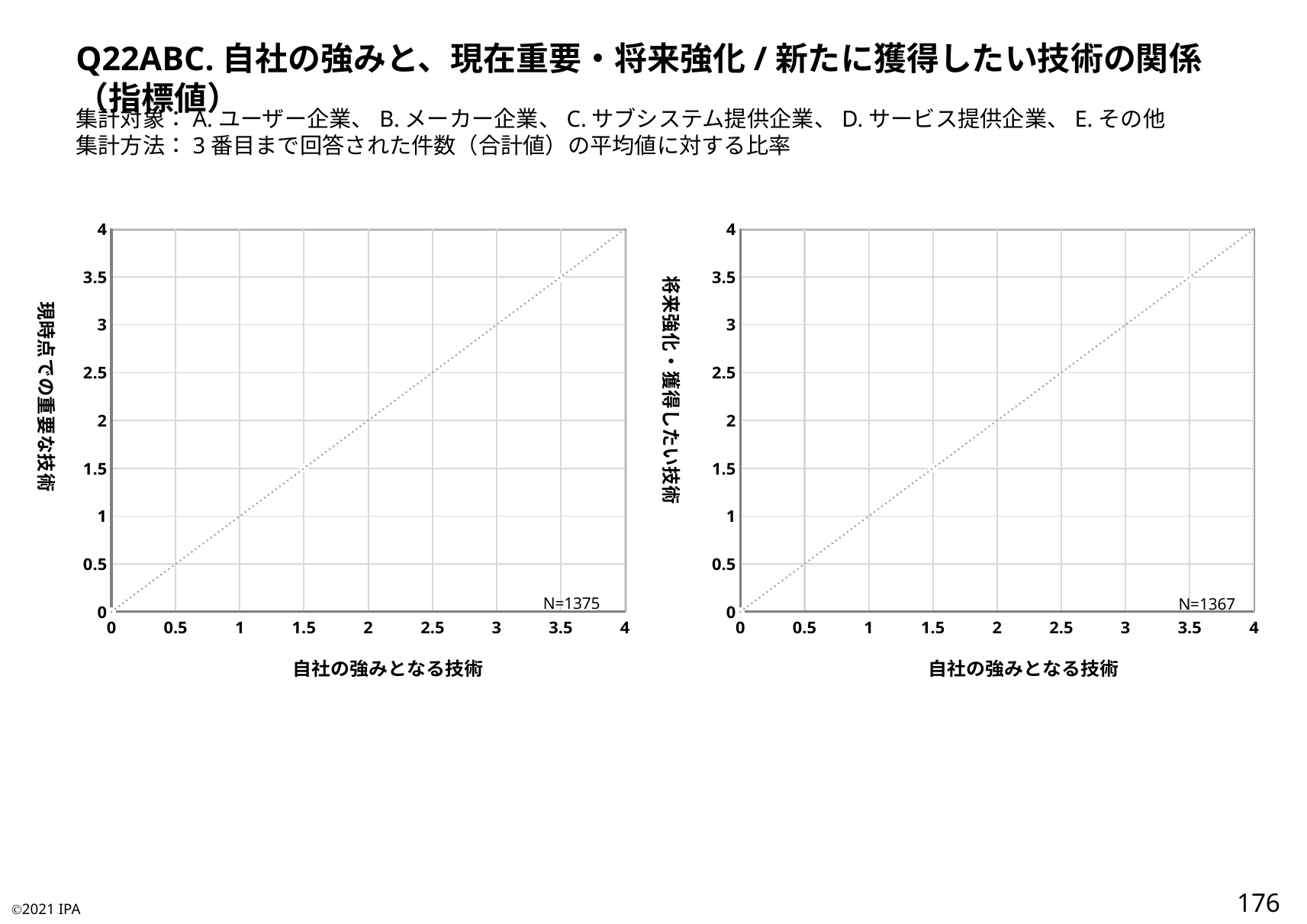
What kind of chart is the left chart (現時点での重要な技術 vs 自社の強みとなる技術)? scatter chart What is the y-axis label of the right chart? 将来強化・獲得したい技術 What kind of chart is the right chart (将来強化・獲得したい技術 vs 自社の強みとなる技術)? scatter chart What is the N value printed on the left chart? N=1375 What is the x-axis label of the left chart? 自社の強みとなる技術 What is the N value printed on the right chart? N=1367